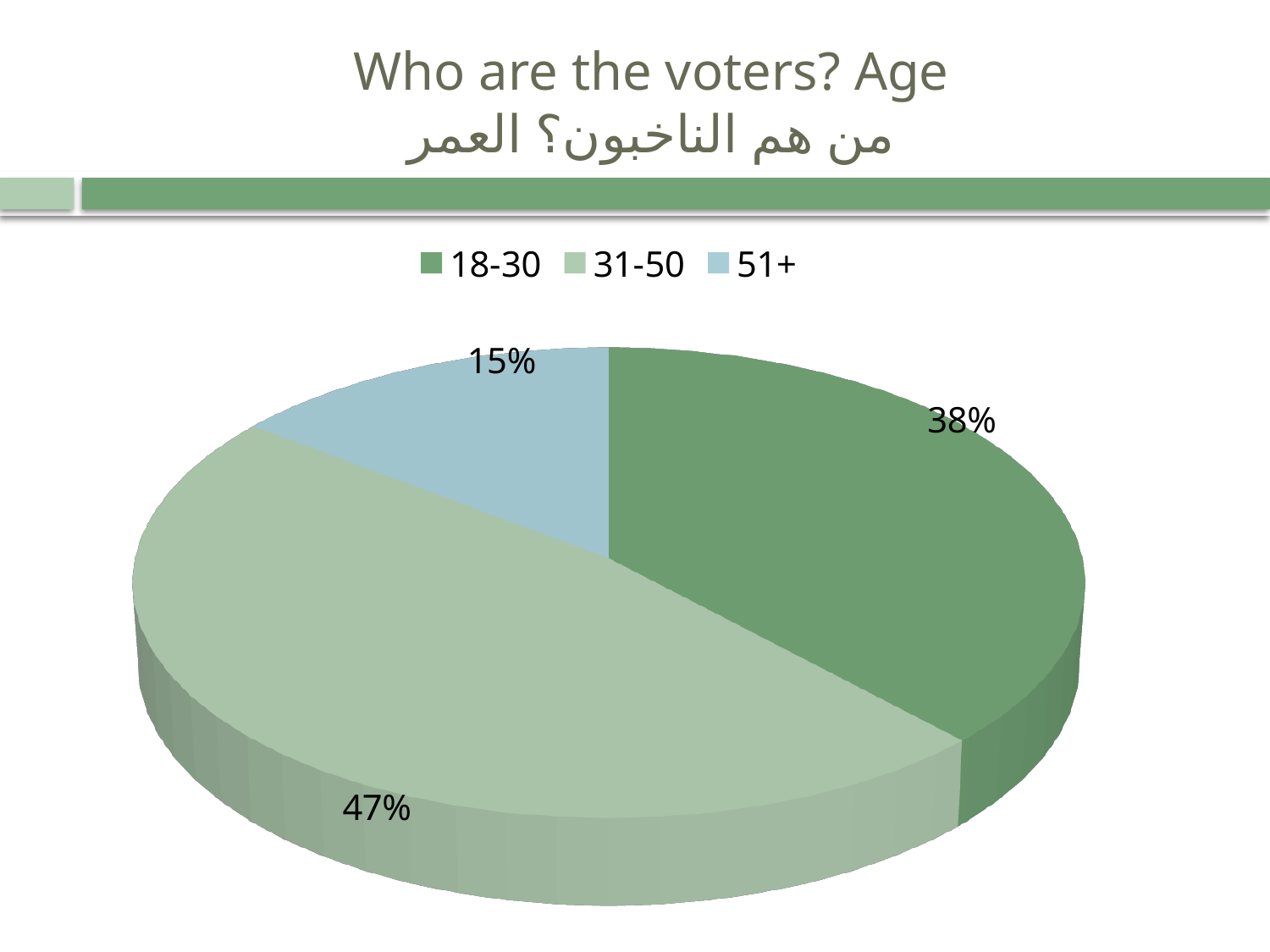
What is the difference in percentage points between the 18-30 and 51+ age groups? 23 What is the difference in percentage points between the 31-50 and 18-30 age groups? 9 What share of voters are aged 51+? 15% How many age groups are shown in the pie chart? 3 What share of voters are aged 18-30? 38% What kind of chart is shown on the slide? Pie chart Which age group has the smallest share of voters? 51+ What share of voters are aged 31-50? 47% Which age group has the largest share of voters? 31-50 What is the English title of the chart slide? Who are the voters? Age How many entries does the legend list? 3 Which age group has a larger share of voters, 18-30 or 51+? 18-30